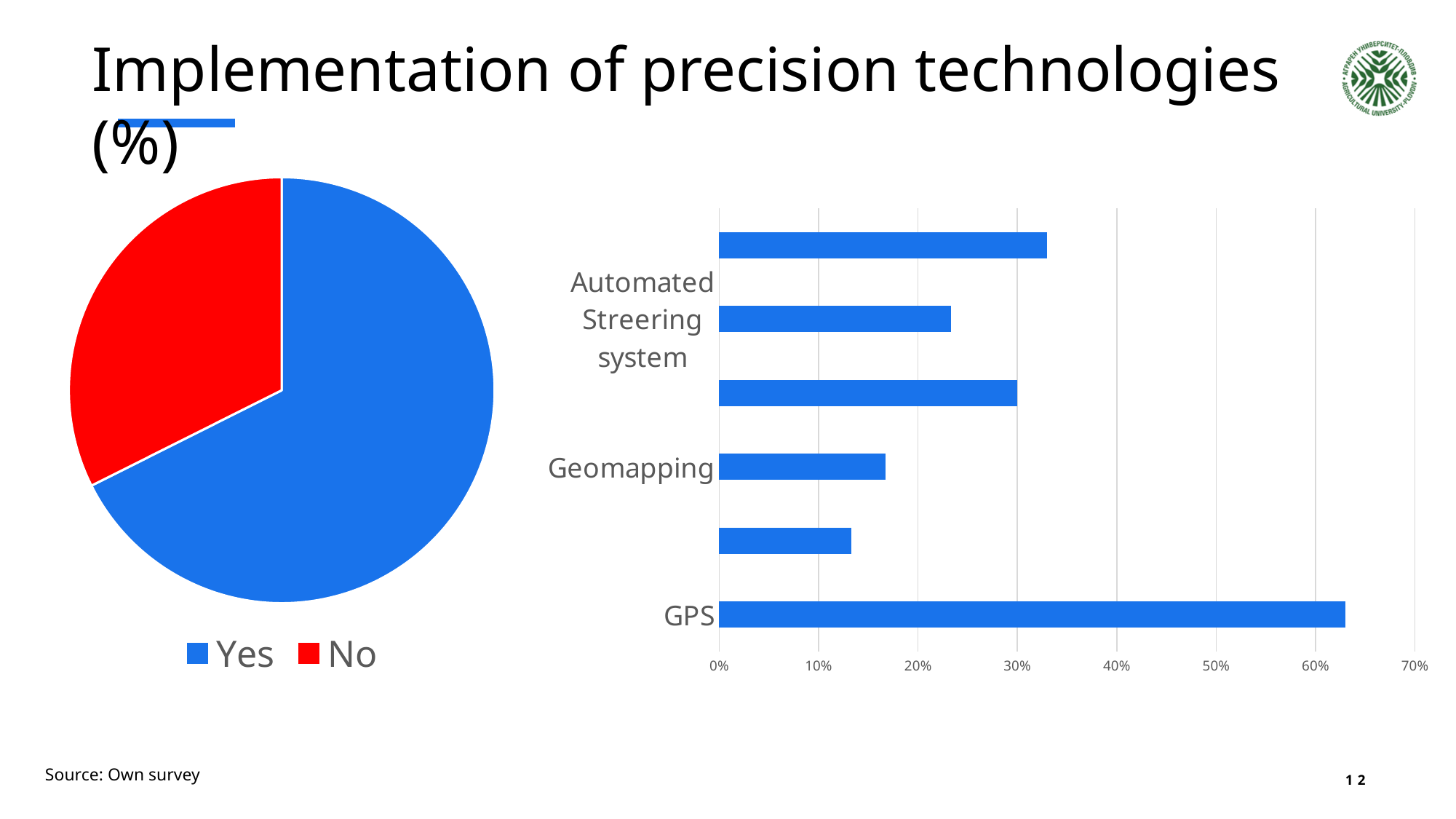
How many entries does the legend of the pie chart on the left list? 2 In the pie chart on the left, which slice is larger, Yes or No? Yes In the bar chart on the right, is the value for Geomapping greater or less than 20%? less In the bar chart on the right, which is larger, the value for GPS or the value for Geomapping? GPS In the pie chart on the left, which category has the smallest slice? No What kind of chart is the chart on the right of the slide? bar chart In the bar chart on the right, is the value for GPS greater or less than 60%? greater In the pie chart on the left, what colour is the Yes slice? blue What kind of chart is the chart on the left of the slide? pie chart In the bar chart on the right, which category has the longest bar? GPS How many bars are plotted in the bar chart on the right? 6 In the bar chart on the right, is the value for Automated Streering system greater or less than 30%? less